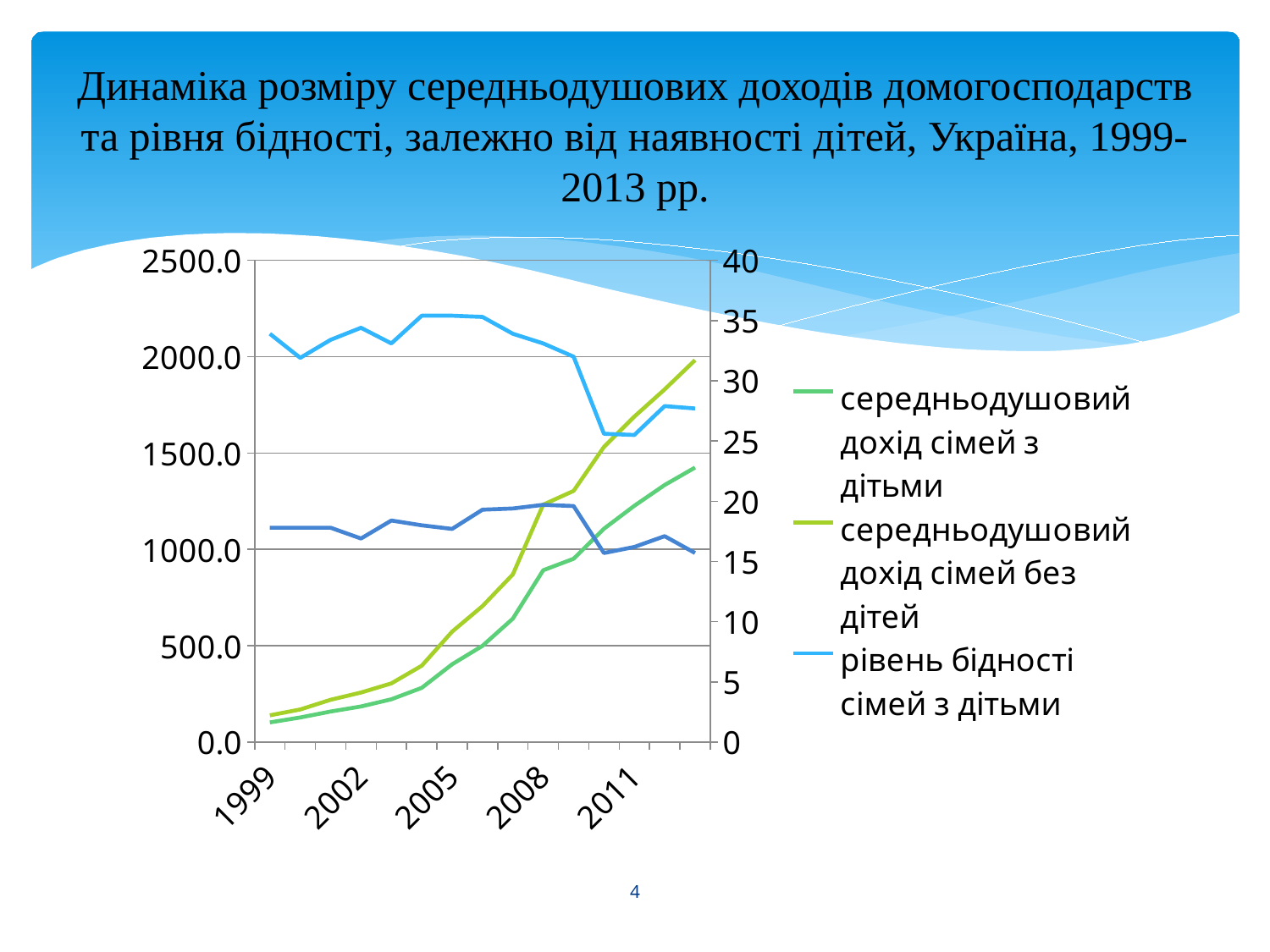
What colour is the line for 'рівень бідності сімей з дітьми' in the legend? light blue Is the value of 'рівень бідності сімей з дітьми' in 2013 greater or less than 30 on the right axis? less What is the first year shown on the x axis? 1999 Does the line for 'середньодушовий дохід сімей без дітей' rise or fall from 1999 to 2013? rise Is the value of 'середньодушовий дохід сімей з дітьми' in 1999 greater or less than 500.0 on the left axis? less What kind of chart is shown on the slide? line chart In 2013, which is higher: 'середньодушовий дохід сімей з дітьми' or 'середньодушовий дохід сімей без дітей'? середньодушовий дохід сімей без дітей Is the value of 'середньодушовий дохід сімей з дітьми' in 2013 greater or less than 1000.0 on the left axis? greater How many series does the legend list? 3 Does the line for 'рівень бідності сімей з дітьми' rise or fall overall from 1999 to 2013? fall